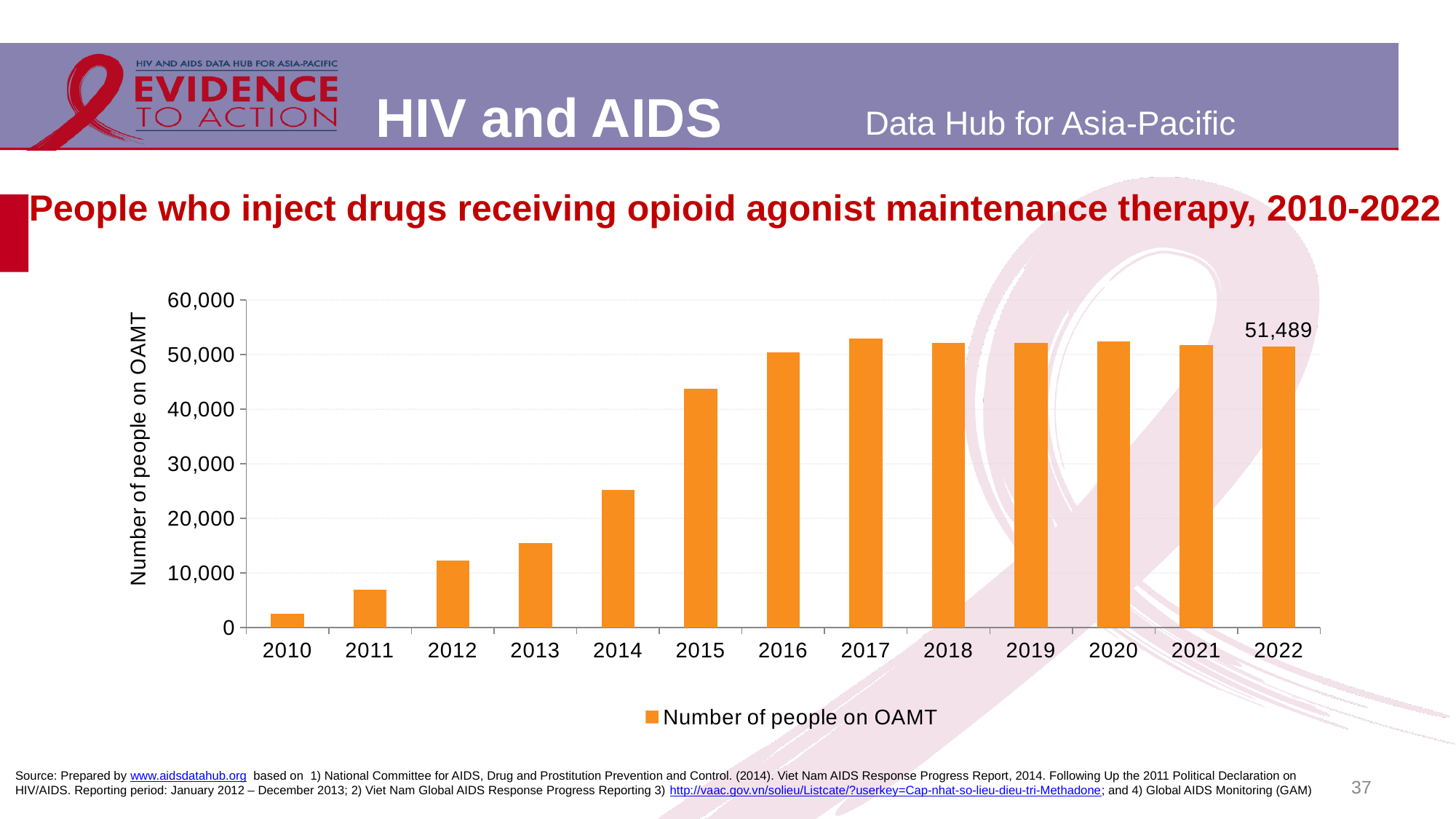
Is the value for 2013 greater or less than 20,000? less What kind of chart is shown on the slide? Bar chart What is the value for 2022 in the chart? 51,489 What is the label on the vertical axis of the chart? Number of people on OAMT Which year has the lowest number of people on OAMT? 2010 Which year has the larger value, 2010 or 2012? 2012 Is the value for 2014 greater or less than 20,000? greater How many series does the legend list? 1 Is the value for 2015 greater or less than 40,000? greater How many years are shown on the x axis of the chart? 13 Which year has the larger value, 2014 or 2015? 2015